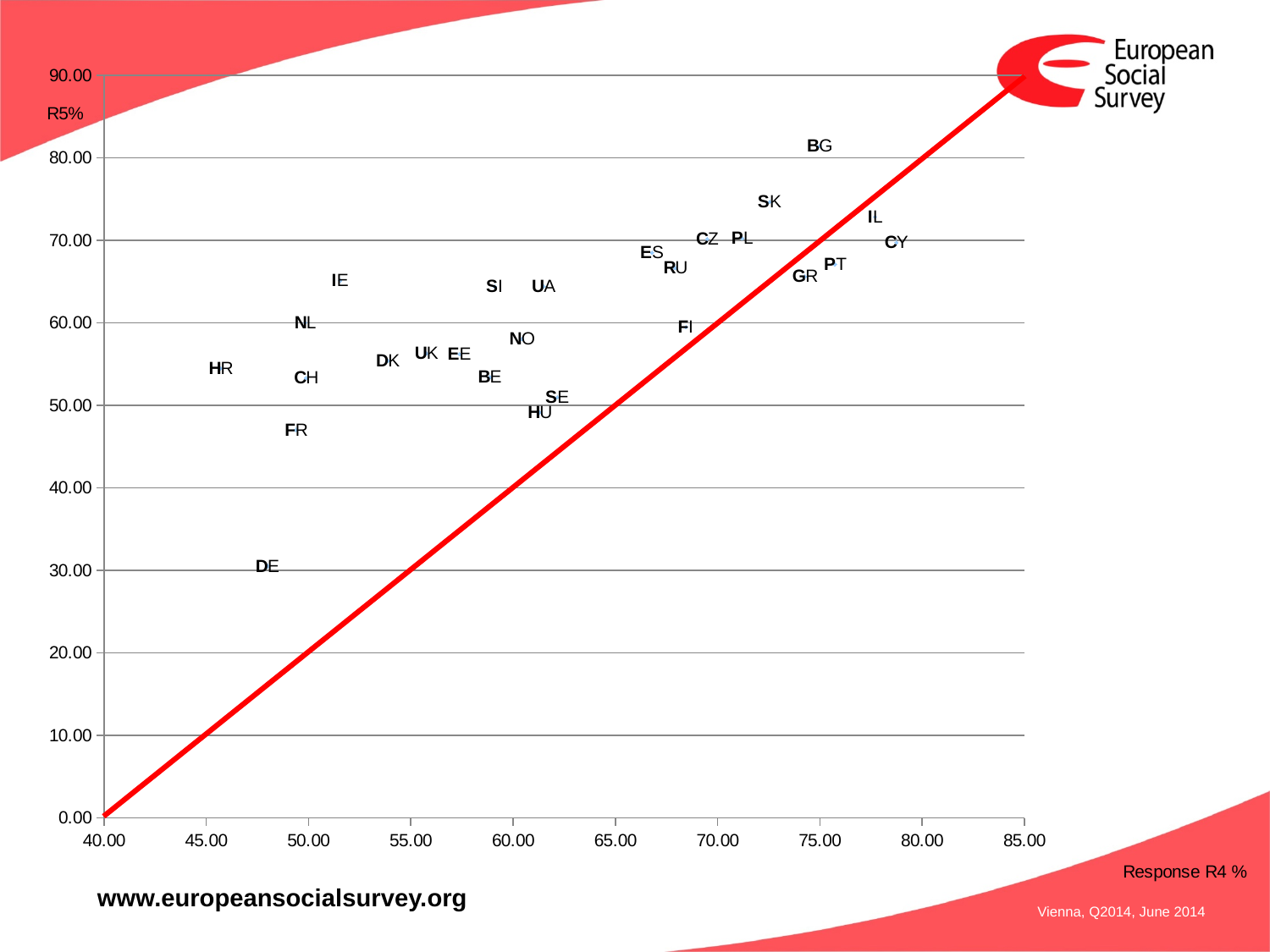
What is the label of the vertical axis? R5% Is the R5% value for IE greater or less than 60.00? greater Which country has the lowest R5% value on the chart? DE Which country has the lowest Response R4 % value on the chart? HR Which has the higher R5% value, BG or DE? BG How many country points are plotted on the chart? 26 What is the label of the horizontal axis? Response R4 % Is the R5% value for DE greater or less than 40.00? less Is the Response R4 % value for CY greater or less than 75.00? greater What kind of chart is shown on the slide? scatter plot Which country has the highest R5% value on the chart? BG